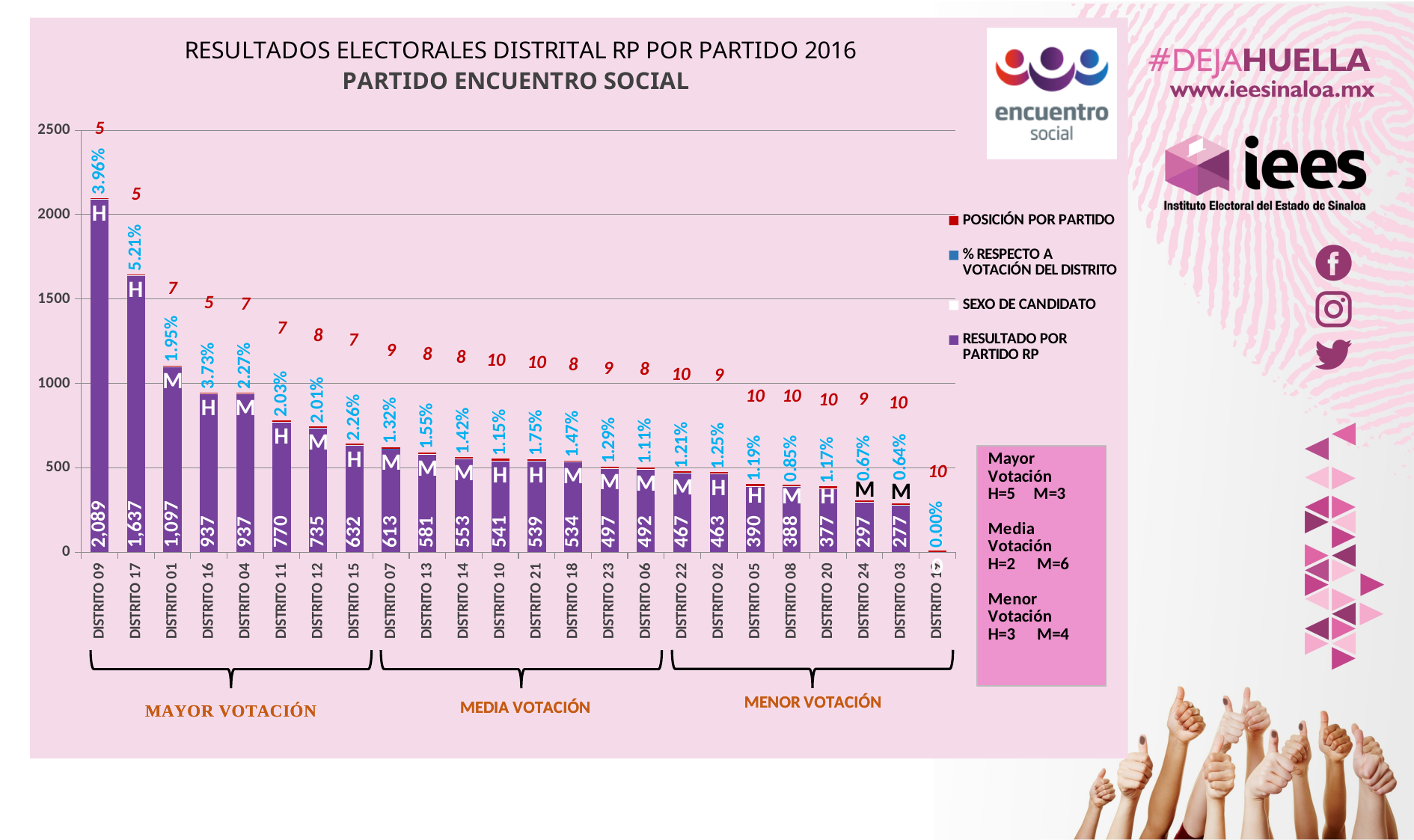
What percentage of the district vote (% RESPECTO A VOTACIÓN DEL DISTRITO) is shown for DISTRITO 17? 5.21% What is the difference between the RP results of DISTRITO 09 and DISTRITO 17? 452 What is the RP result for DISTRITO 24? 297 What kind of chart is shown on the slide? Bar chart How many districts are plotted on the chart? 24 What is the POSICIÓN POR PARTIDO shown for DISTRITO 01? 7 Which has a larger RP result, DISTRITO 11 or DISTRITO 12? DISTRITO 11 Which district has the highest RP result? DISTRITO 09 How many series does the legend list? 4 What is the RP result (RESULTADO POR PARTIDO RP) for DISTRITO 09? 2,089 Which party is named in the chart's subtitle? PARTIDO ENCUENTRO SOCIAL Do the RP results rise or fall from left to right along the x axis? Fall